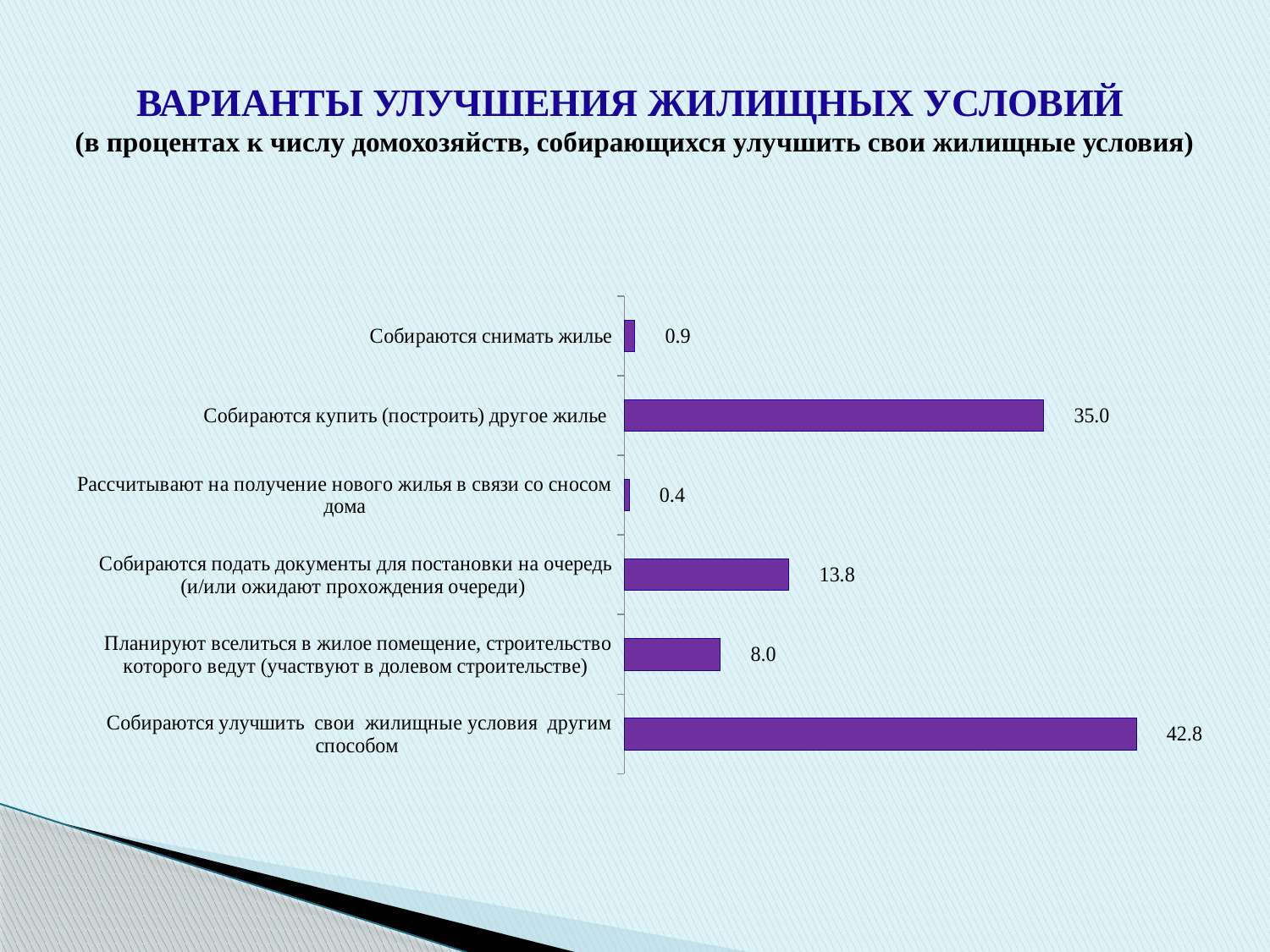
What is the value for "Собираются подать документы для постановки на очередь (и/или ожидают прохождения очереди)"? 13.8 What is the value for "Собираются купить (построить) другое жилье"? 35.0 What is the difference between the values for "Собираются подать документы для постановки на очередь (и/или ожидают прохождения очереди)" and "Планируют вселиться в жилое помещение, строительство которого ведут (участвуют в долевом строительстве)"? 5.8 What is the value for "Собираются снимать жилье"? 0.9 Which category has the lowest value? Рассчитывают на получение нового жилья в связи со сносом дома Which category has the highest value? Собираются улучшить свои жилищные условия другим способом What is the value for "Планируют вселиться в жилое помещение, строительство которого ведут (участвуют в долевом строительстве)"? 8.0 Which is larger: the value for "Собираются снимать жилье" or the value for "Рассчитывают на получение нового жилья в связи со сносом дома"? Собираются снимать жилье What colour are the bars in the chart? Purple What is the difference between the values for "Собираются улучшить свои жилищные условия другим способом" and "Собираются купить (построить) другое жилье"? 7.8 What kind of chart is shown on the slide? Bar chart How many categories are shown in the chart? 6